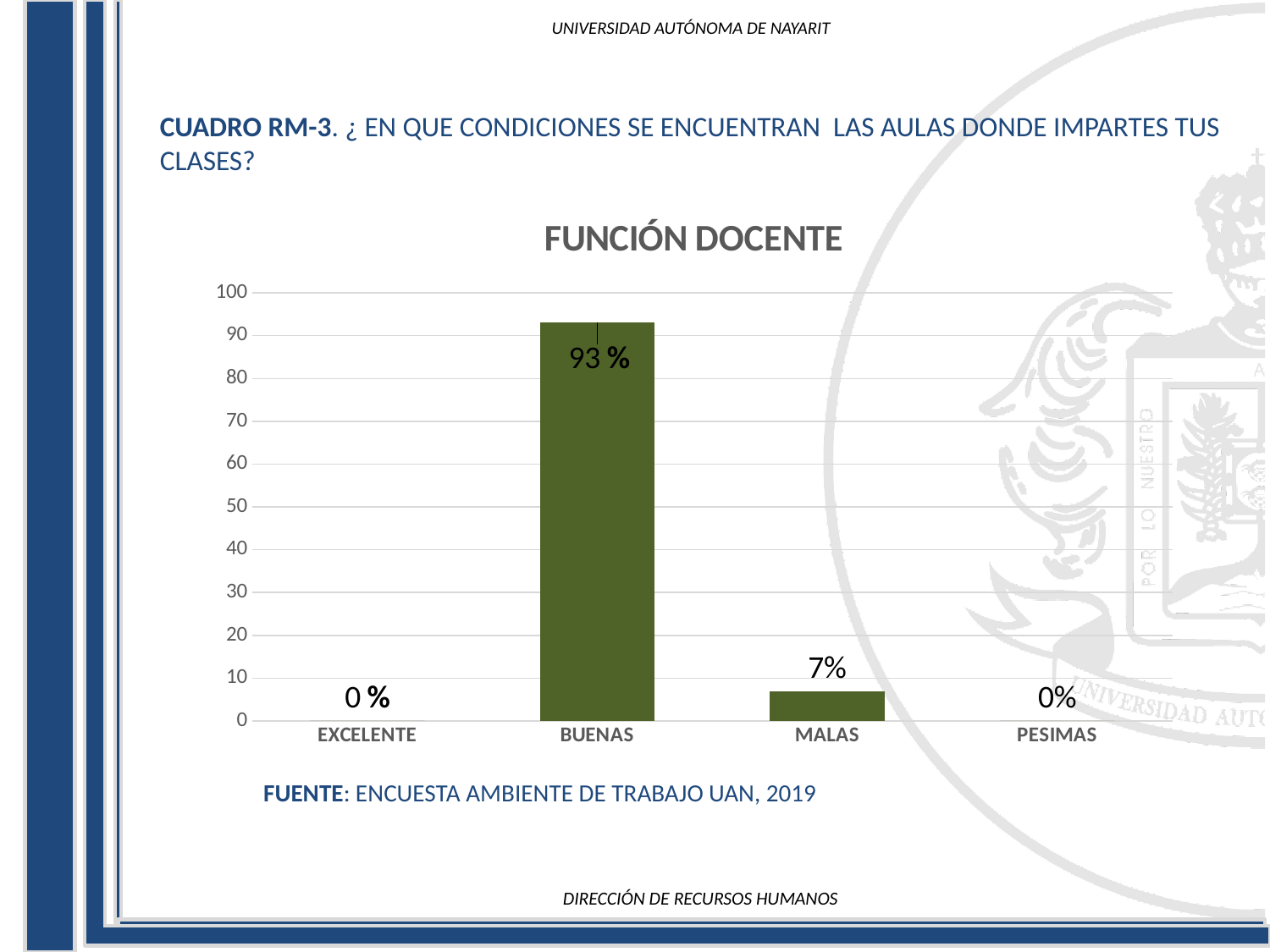
How many categories are shown on the x axis? 4 What kind of chart is shown on the slide? bar chart What is the value for BUENAS? 93 % Which is larger, the value for BUENAS or the value for MALAS? BUENAS Is the value for MALAS greater or less than 10? less What is the value for MALAS? 7% What is the value for PESIMAS? 0% Is the value for BUENAS greater or less than 90? greater What is the title of the chart? FUNCIÓN DOCENTE What is the value for EXCELENTE? 0 % Which category has the highest value? BUENAS What is the difference between the values for BUENAS and MALAS? 86%